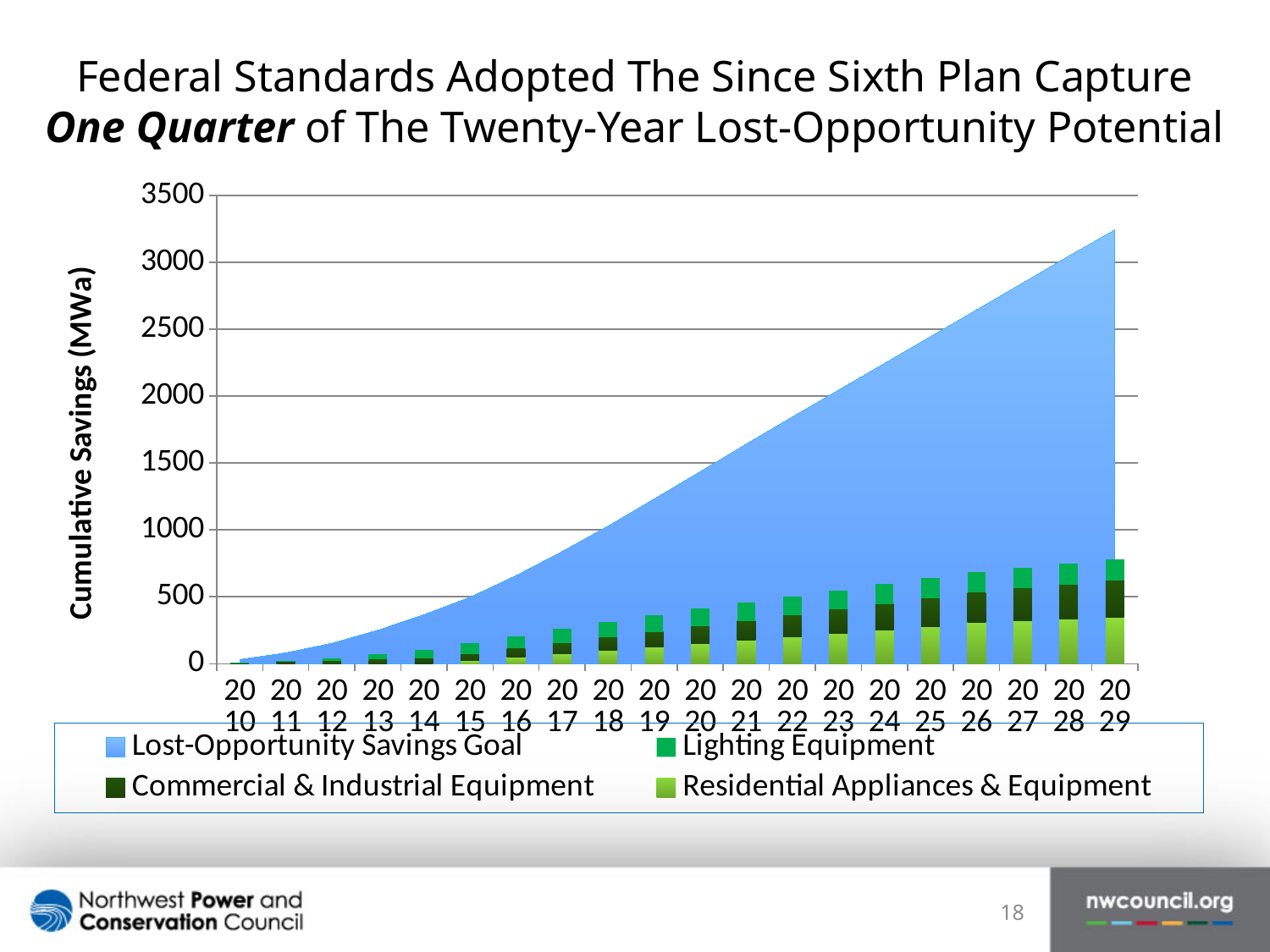
Is the Lost-Opportunity Savings Goal in 2025 greater or less than 2000? greater Is the total of the stacked bar for 2029 greater or less than 500? greater What kind of chart is this? A combination of an area chart and a stacked bar chart How many years are shown along the x axis? 20 Is the total of the stacked bar for 2029 greater or less than 1000? less How many series does the legend list? 4 Does the Lost-Opportunity Savings Goal rise or fall from 2010 to 2029? Rises Which year has the smallest stacked bar? 2010 In 2029, which is larger: the Lost-Opportunity Savings Goal or the total of the stacked bar? Lost-Opportunity Savings Goal Which year has the tallest stacked bar? 2029 What is the label on the y axis? Cumulative Savings (MWa)